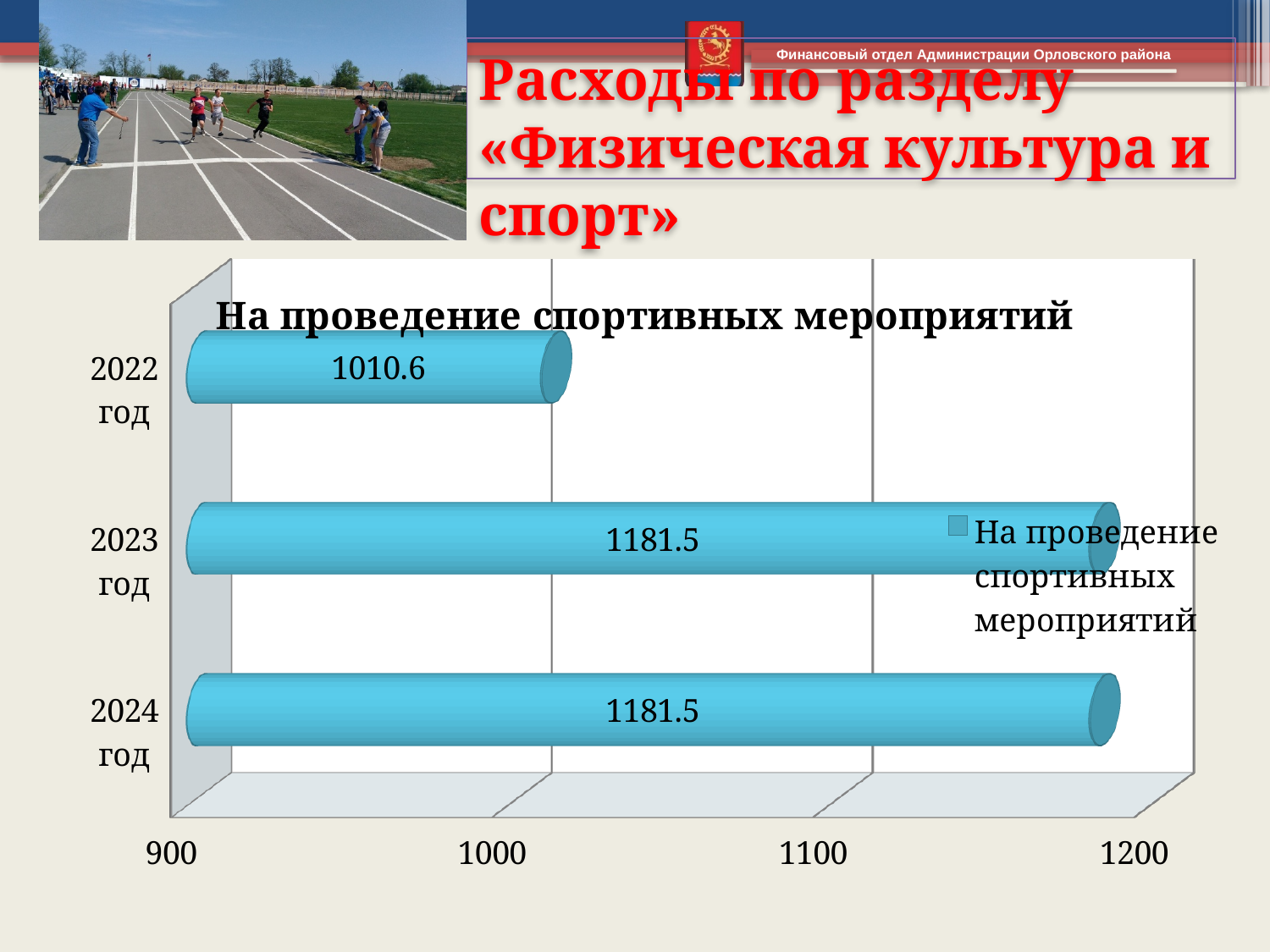
What is the value for 2022 год? 1010.6 Which year has the lowest value? 2022 год What is the value for 2023 год? 1181.5 What kind of chart is shown on the slide? bar chart What is the title of the chart? На проведение спортивных мероприятий What is the difference between the values for 2023 год and 2022 год? 170.9 What is the value for 2024 год? 1181.5 How many series does the legend list? 1 Which is larger, the value for 2022 год or the value for 2024 год? 2024 год Is the value for 2023 год greater or less than 1100? greater How many years are shown on the chart? 3 Is the value for 2022 год greater or less than 1100? less